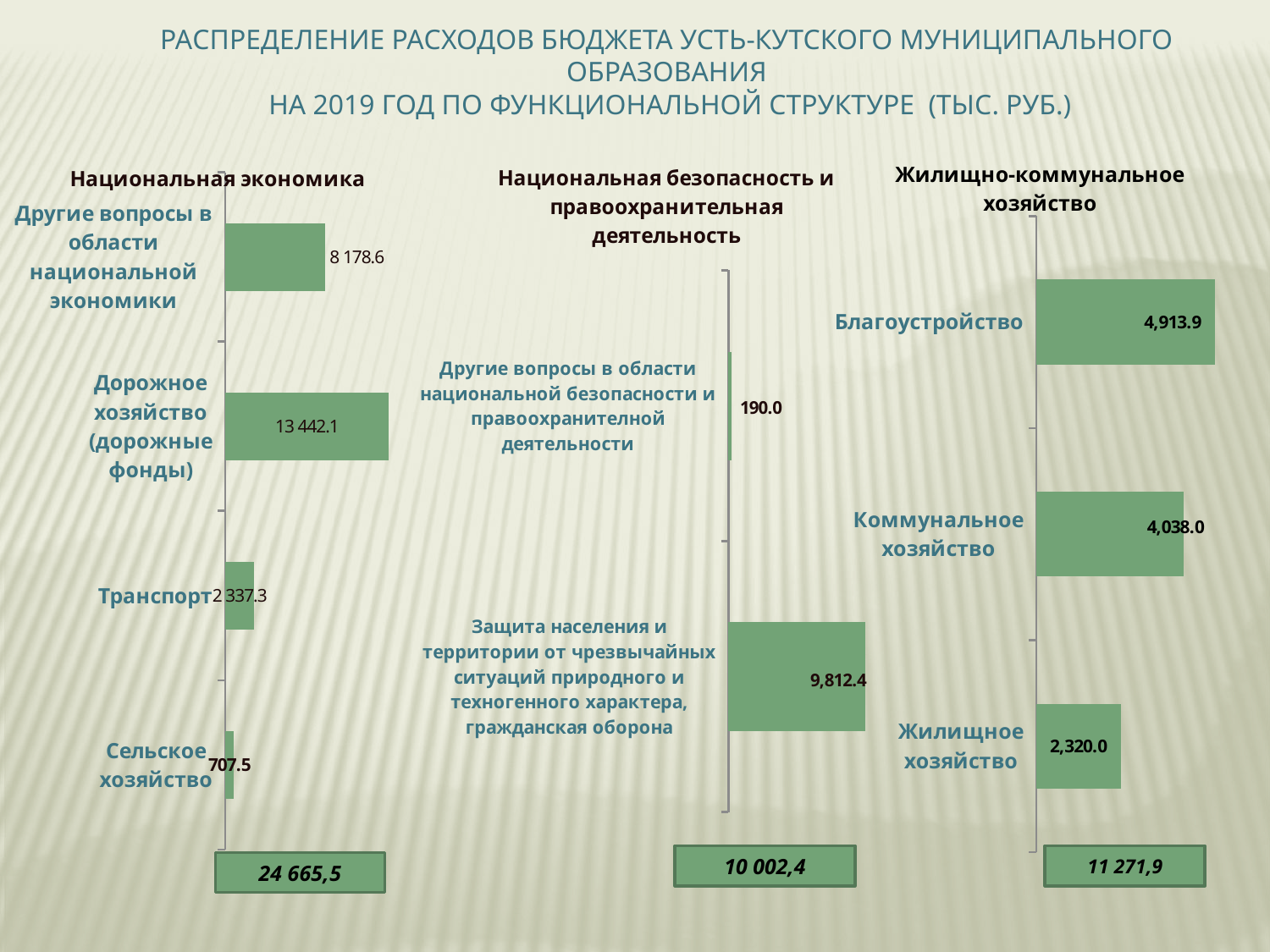
In the 'Национальная экономика' chart, how many categories are plotted? 4 In the 'Национальная экономика' chart, what is the value for Дорожное хозяйство (дорожные фонды)? 13 442.1 In the 'Национальная безопасность и правоохранительная деятельность' chart, what is the value for Защита населения и территории от чрезвычайных ситуаций природного и техногенного характера, гражданская оборона? 9,812.4 In the 'Национальная экономика' chart, what is the difference between Дорожное хозяйство (дорожные фонды) and Другие вопросы в области национальной экономики? 5 263.5 What type of chart is the 'Жилищно-коммунальное хозяйство' chart? Bar chart In the 'Жилищно-коммунальное хозяйство' chart, what is the difference between Благоустройство and Коммунальное хозяйство? 875.9 In the 'Жилищно-коммунальное хозяйство' chart, what is the value for Коммунальное хозяйство? 4,038.0 What total is shown in the box below the 'Национальная экономика' chart? 24 665,5 In the 'Национальная экономика' chart, which category has the highest value? Дорожное хозяйство (дорожные фонды) In the 'Жилищно-коммунальное хозяйство' chart, which is larger: Благоустройство or Жилищное хозяйство? Благоустройство In the 'Национальная экономика' chart, which category has the lowest value? Сельское хозяйство In the 'Национальная безопасность и правоохранительная деятельность' chart, what is the value for Другие вопросы в области национальной безопасности и правоохранителной деятельности? 190.0